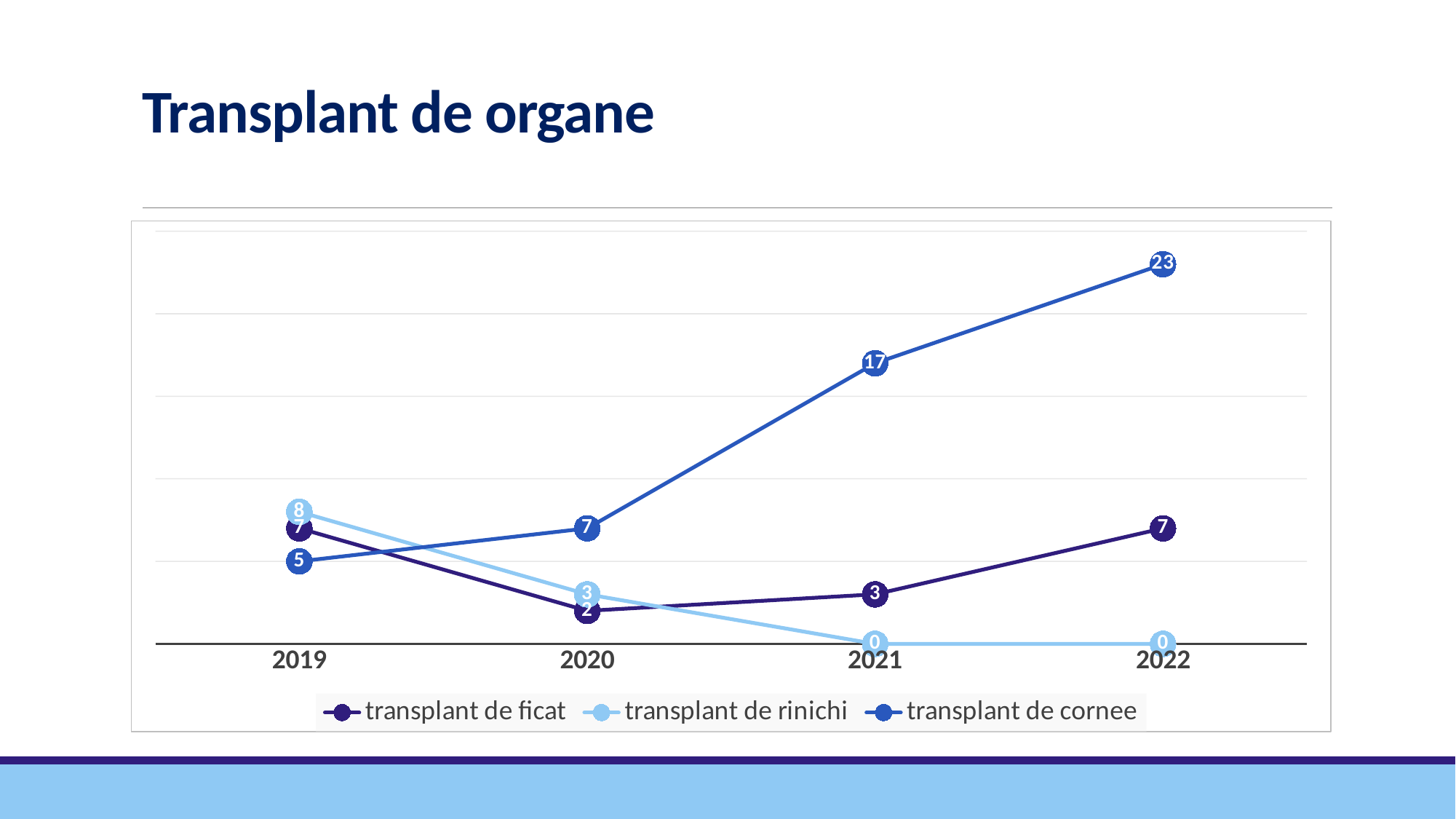
What is the value for transplant de cornee in 2021? 17 How many years are shown on the x axis? 4 Does transplant de cornee rise or fall from 2019 to 2022? rise What is the value for transplant de ficat in 2020? 2 How many series does the legend list? 3 What is the value for transplant de cornee in 2022? 23 In which year is transplant de ficat lowest? 2020 What is the value for transplant de rinichi in 2019? 8 Which is larger in 2020: transplant de rinichi or transplant de ficat? transplant de rinichi In which year is transplant de cornee highest? 2022 What kind of chart is shown on the slide? line chart What is the difference between transplant de cornee in 2022 and in 2021? 6